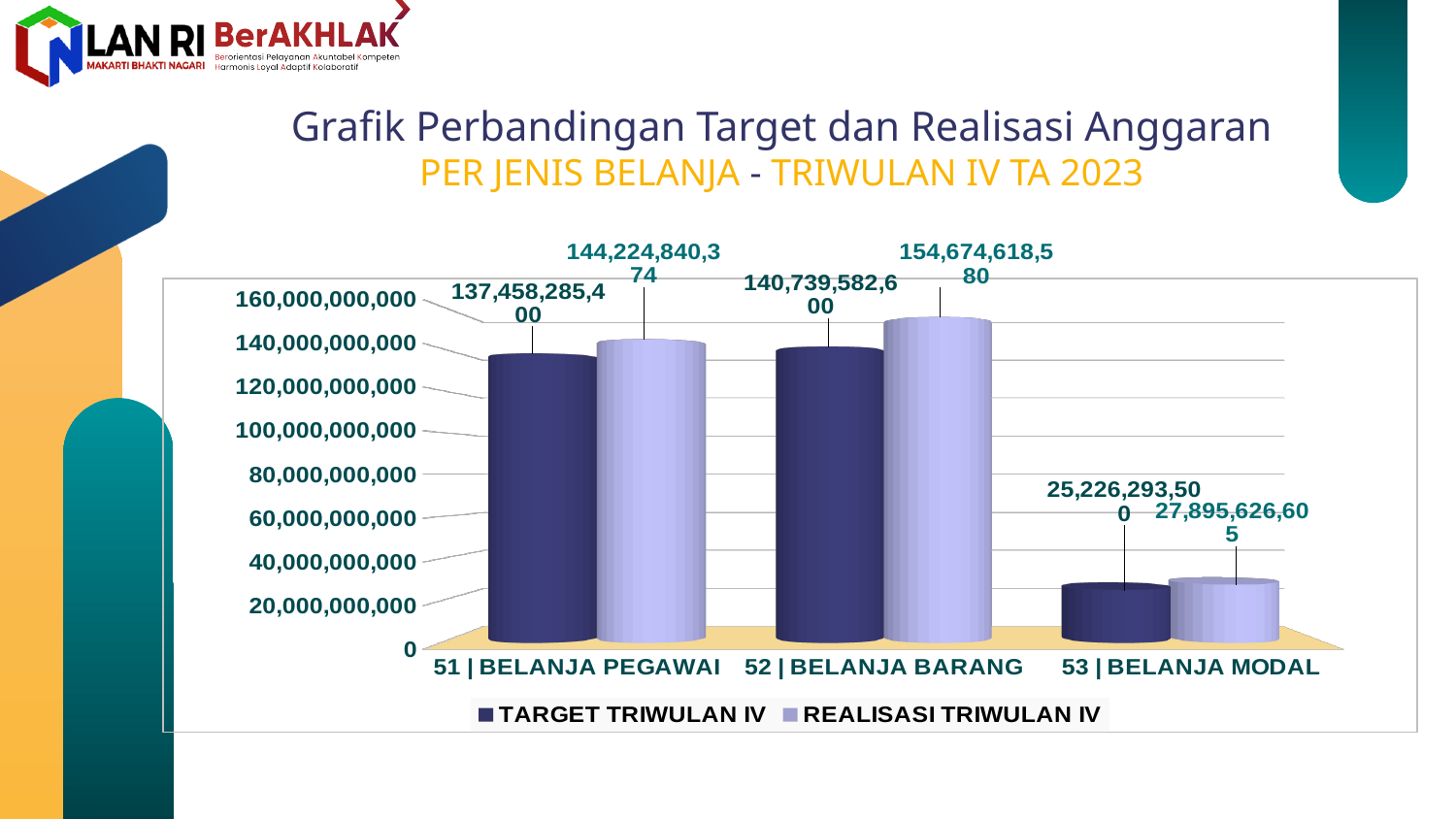
What is the REALISASI TRIWULAN IV value for 53 | BELANJA MODAL? 27,895,626,605 Which category has the lowest TARGET TRIWULAN IV value? 53 | BELANJA MODAL How many categories are shown on the x axis? 3 Which category has the highest REALISASI TRIWULAN IV value? 52 | BELANJA BARANG What is the TARGET TRIWULAN IV value for 51 | BELANJA PEGAWAI? 137,458,285,400 What is the REALISASI TRIWULAN IV value for 52 | BELANJA BARANG? 154,674,618,580 How many series does the legend list? 2 Which is larger for 51 | BELANJA PEGAWAI: TARGET TRIWULAN IV or REALISASI TRIWULAN IV? REALISASI TRIWULAN IV What kind of chart is shown on the slide? Bar chart What is the TARGET TRIWULAN IV value for 53 | BELANJA MODAL? 25,226,293,500 Is the TARGET TRIWULAN IV value for 53 | BELANJA MODAL greater or less than 40,000,000,000? less What is the difference between REALISASI TRIWULAN IV and TARGET TRIWULAN IV for 52 | BELANJA BARANG? 13,935,035,980